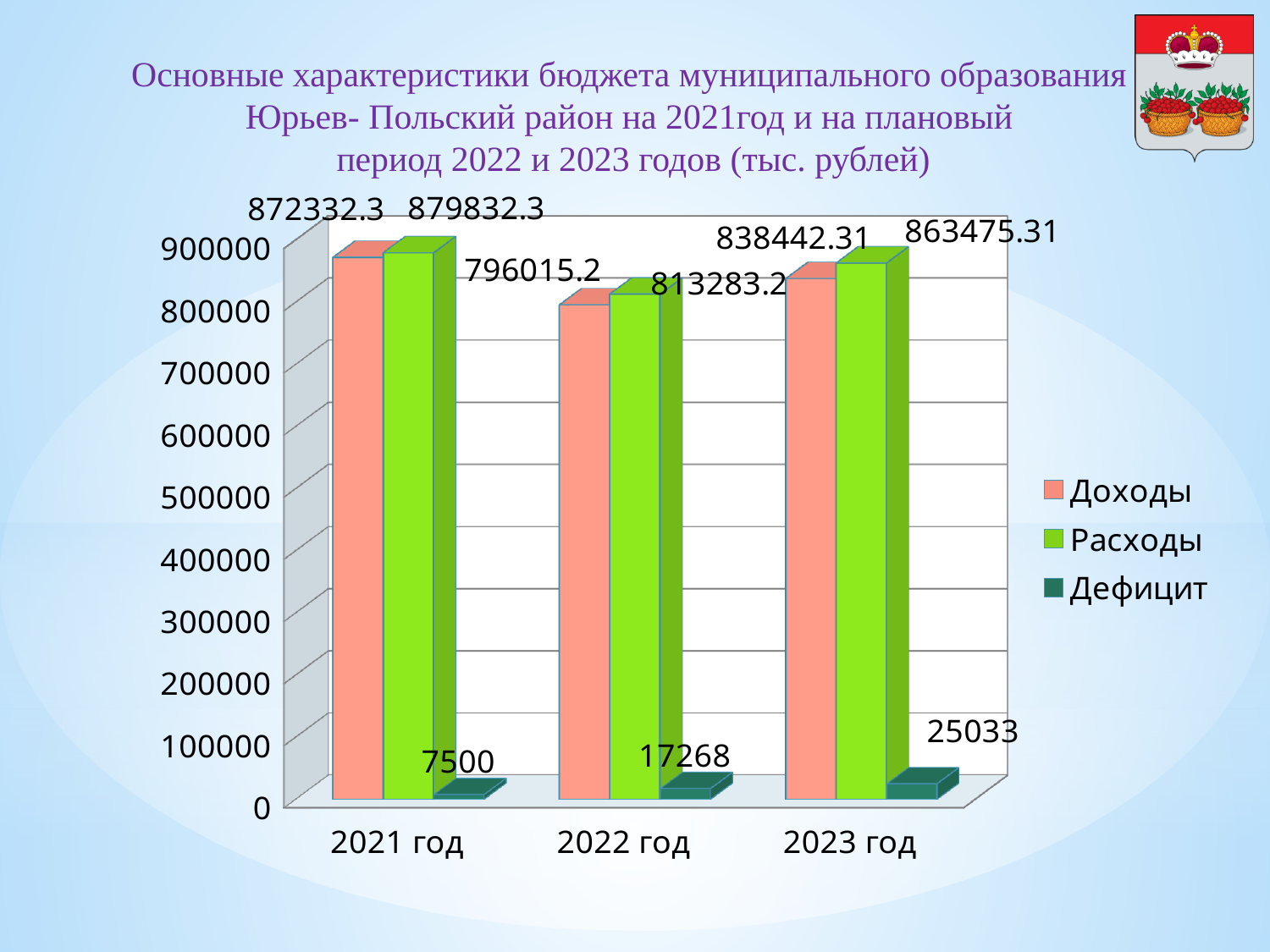
In which year is Доходы the lowest? 2022 год What is the value of Расходы for 2022 год? 813283.2 What is the value of Расходы for 2023 год? 863475.31 How many series does the legend list? 3 How many years are shown on the x axis? 3 Which is larger for 2023 год: Доходы or Расходы? Расходы What is the value of Доходы for 2021 год? 872332.3 What is the value of Дефицит for 2023 год? 25033 In which year is Дефицит the highest? 2023 год What is the difference between Расходы and Доходы for 2022 год? 17268 What kind of chart is shown on the slide? Bar chart Does Дефицит rise or fall from 2021 год to 2023 год? Rises